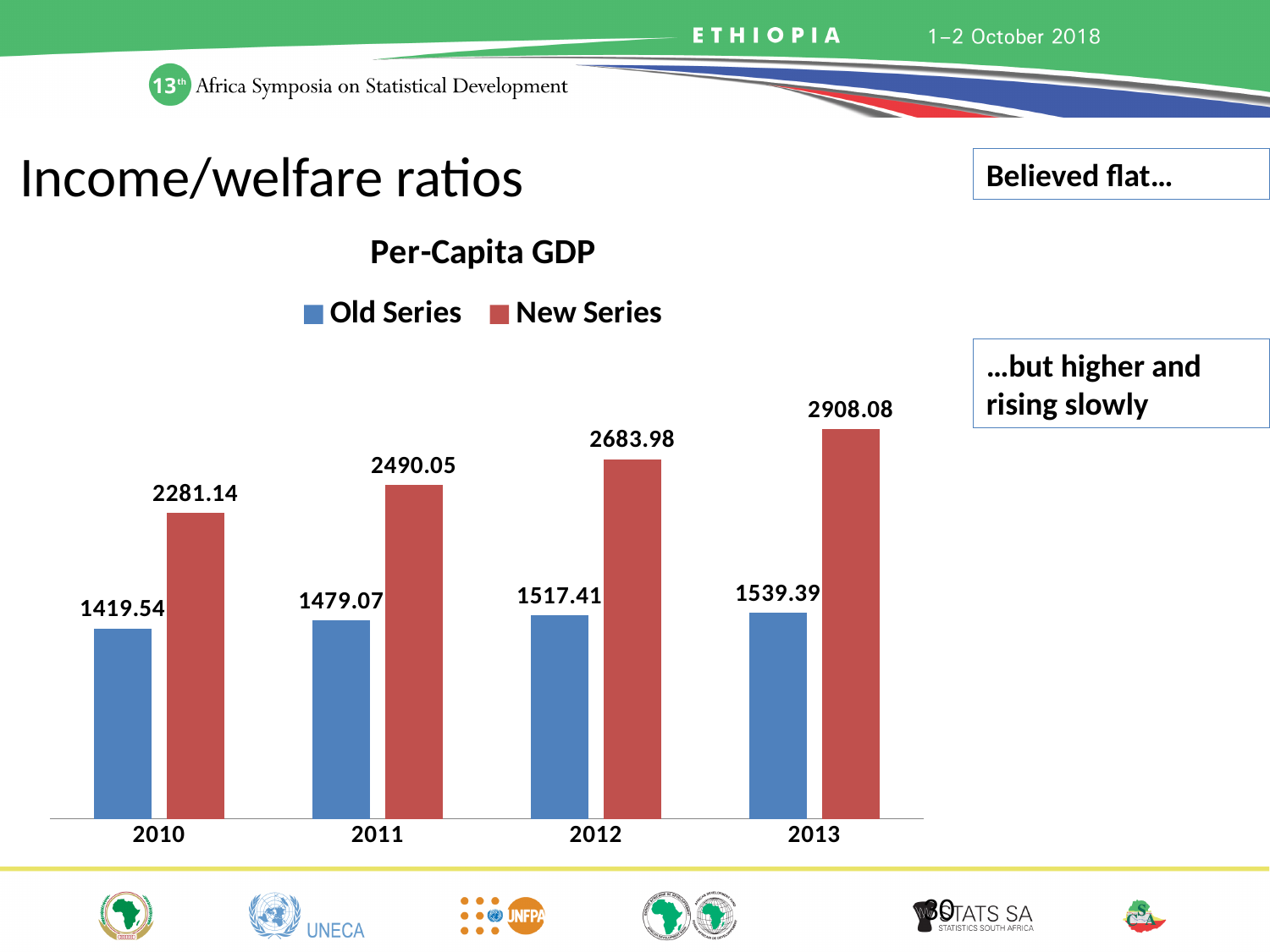
Which year has the highest New Series value? 2013 What type of chart is used to show Per-Capita GDP? Bar chart Which is larger in 2012, the Old Series value or the New Series value? New Series Do the Old Series values rise or fall from 2010 to 2013? Rise What is the Old Series value for 2010 in the Per-Capita GDP chart? 1419.54 What is the New Series value for 2011? 2490.05 Which year has the lowest Old Series value? 2010 By how much did the New Series value increase from 2010 to 2013? 626.94 How many years are shown on the x axis of the chart? 4 What is the difference between the New Series and Old Series values in 2013? 1368.69 What is the New Series value for 2013 in the Per-Capita GDP chart? 2908.08 How many series does the legend list? 2